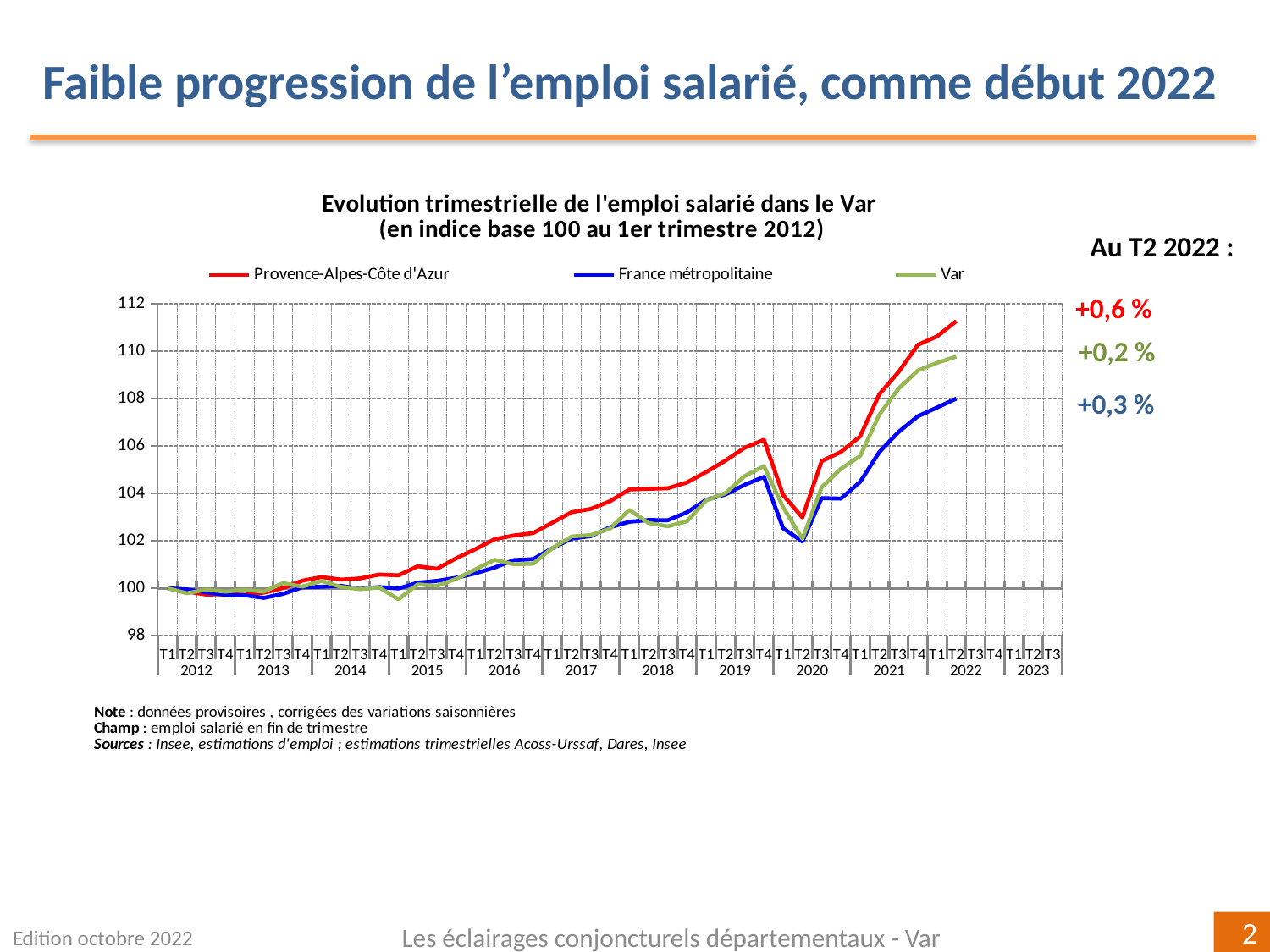
What kind of chart is shown on the slide? line chart Which series is the lowest at T2 2022? France métropolitaine Is the value for France métropolitaine at T2 2022 greater or less than 106? greater How many years are labelled on the x axis? 12 What is the base of the index used in the chart, according to its title? base 100 au 1er trimestre 2012 Overall, do the series rise or fall from 2012 to 2022? rise At T2 2022, which is higher: Var or France métropolitaine? Var How many series does the legend list? 3 Is the value for Var at T1 2015 greater or less than 100? less Is the value for Provence-Alpes-Côte d'Azur at T2 2022 greater or less than 110? greater Which series is the highest at T2 2022? Provence-Alpes-Côte d'Azur